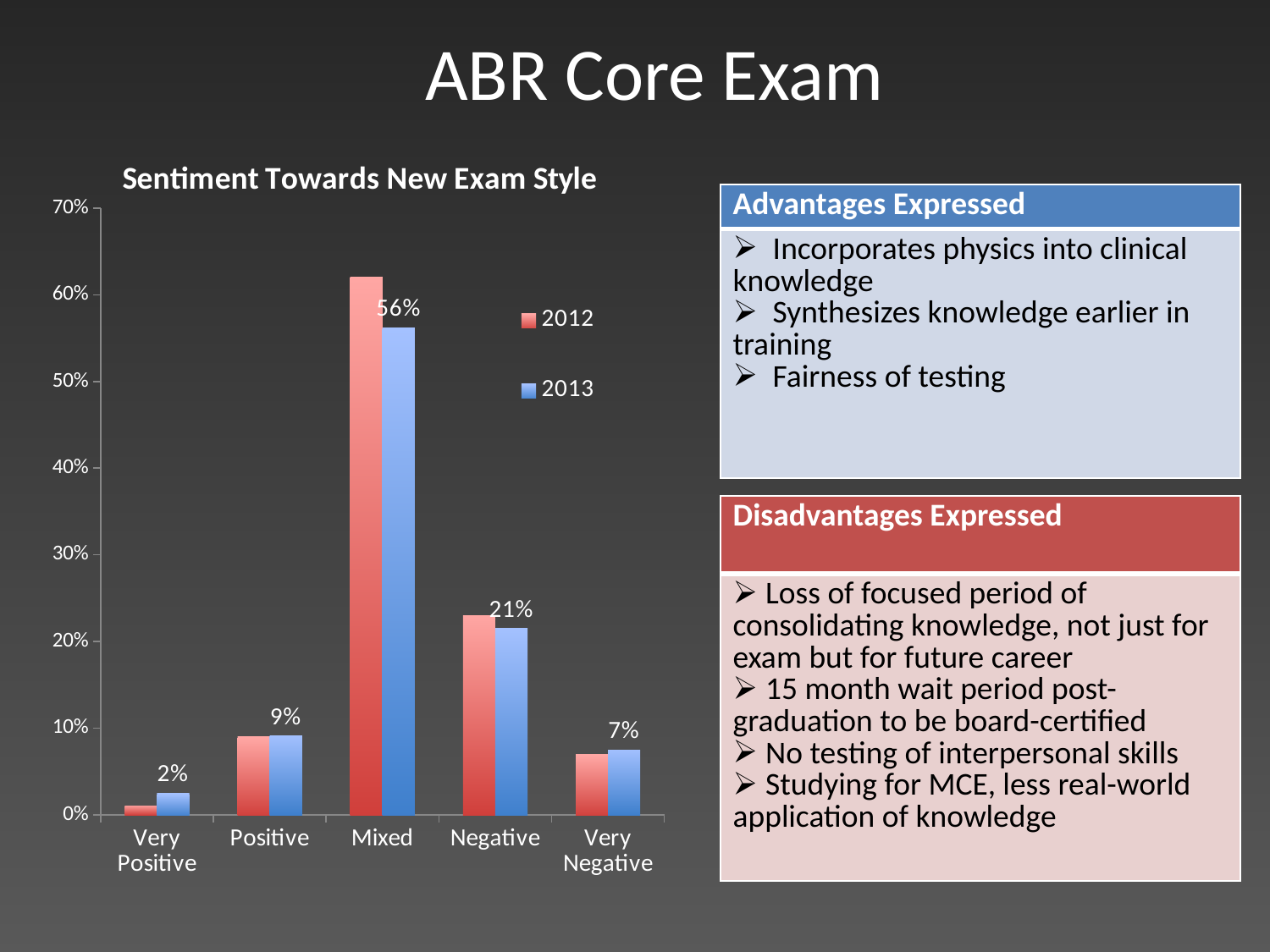
Which category has the highest value for 2013? Mixed Which category has the lowest value for 2012? Very Positive What type of chart is shown on the slide? bar chart What is the 2013 value for the Mixed category? 56% What is the 2013 value for the Negative category? 21% What is the 2013 value for the Very Positive category? 2% How many sentiment categories are shown on the x axis? 5 How many series does the chart legend list? 2 Is the 2012 value for Mixed greater or less than 60%? greater What is the title of the chart? Sentiment Towards New Exam Style What is the difference between the 2013 values for Mixed and Negative? 35% What is the 2013 value for the Very Negative category? 7%